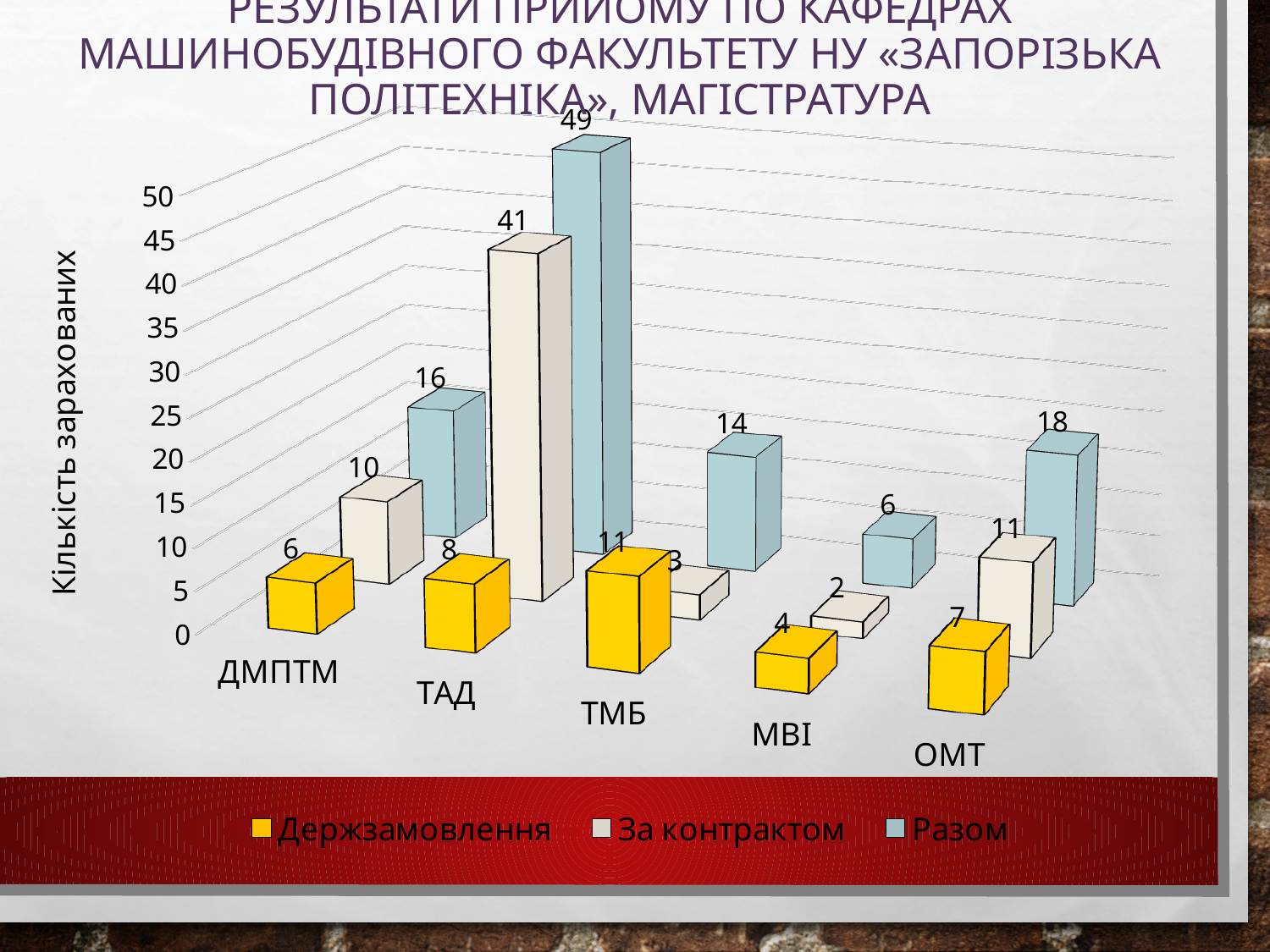
Which category has the highest Разом value? ТАД Which is larger: За контрактом for ОМТ or За контрактом for ДМПТМ? За контрактом for ОМТ Which colour represents the Разом series in the legend? light blue What is the value of Разом for ОМТ? 18 How many series does the legend list? 3 What is the value of За контрактом for ТАД? 41 What is the difference between the Разом values for ТАД and ДМПТМ? 33 How many categories are shown on the x axis? 5 What is the label of the vertical axis? Кількість зарахованих Which category has the lowest Держзамовлення value? МВІ What is the value of Держзамовлення for ТМБ? 11 What kind of chart is shown on the slide? bar chart